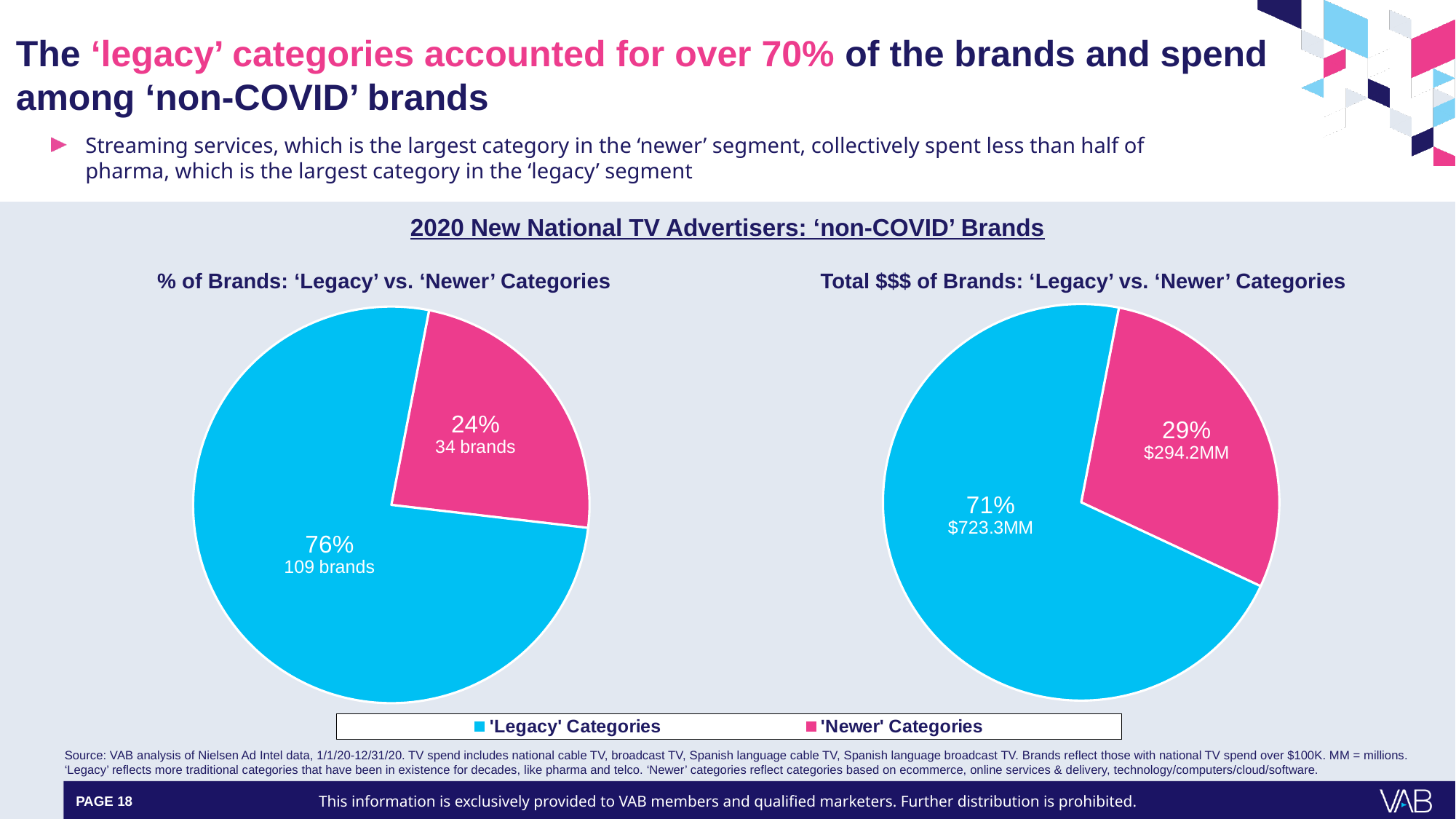
In the '% of Brands: 'Legacy' vs. 'Newer' Categories' chart, how many brands are in 'Legacy' Categories? 109 brands In the 'Total $$$ of Brands: 'Legacy' vs. 'Newer' Categories' chart, what is the total spend for 'Newer' Categories? $294.2MM In the '% of Brands: 'Legacy' vs. 'Newer' Categories' chart, which category has the larger slice? 'Legacy' Categories What colour represents 'Newer' Categories in the legend? Pink In the 'Total $$$ of Brands: 'Legacy' vs. 'Newer' Categories' chart, what share of spend is in 'Newer' Categories? 29% In the 'Total $$$ of Brands: 'Legacy' vs. 'Newer' Categories' chart, what is the total spend for 'Legacy' Categories? $723.3MM What kind of chart is the 'Total $$$ of Brands: 'Legacy' vs. 'Newer' Categories' chart? Pie chart In the 'Total $$$ of Brands: 'Legacy' vs. 'Newer' Categories' chart, which category has the smaller slice? 'Newer' Categories In the '% of Brands: 'Legacy' vs. 'Newer' Categories' chart, how many brands are in 'Newer' Categories? 34 brands In the '% of Brands: 'Legacy' vs. 'Newer' Categories' chart, how many more brands are in 'Legacy' Categories than in 'Newer' Categories? 75 brands How many slices does the '% of Brands: 'Legacy' vs. 'Newer' Categories' chart have? 2 In the '% of Brands: 'Legacy' vs. 'Newer' Categories' chart, what share of brands is in 'Legacy' Categories? 76%